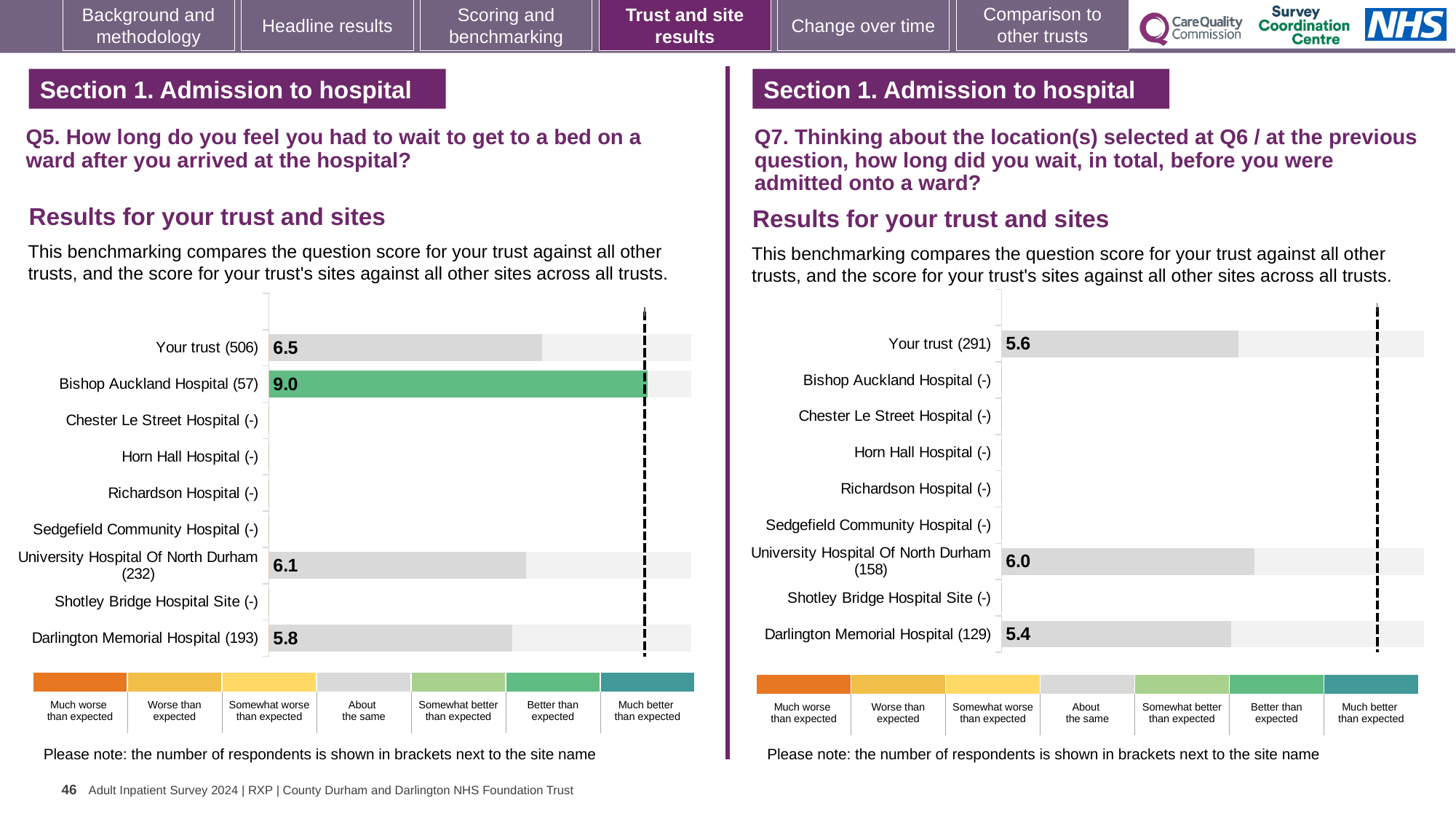
On the Q7 chart (right), what is the score for University Hospital Of North Durham? 6.0 What kind of chart is the Q7 chart (right)? Bar chart On the Q7 chart (right), what is the difference between the University Hospital Of North Durham score and the Darlington Memorial Hospital score? 0.6 On the Q5 chart (left), which site or trust row has the highest score? Bishop Auckland Hospital On the Q5 chart (left), what is the score for Bishop Auckland Hospital? 9.0 How many rows (trust and sites) are listed on the Q5 chart (left)? 9 On the Q5 chart (left), which is larger: the score for University Hospital Of North Durham or the score for Darlington Memorial Hospital? University Hospital Of North Durham On the Q5 chart (left), what is the score for Darlington Memorial Hospital? 5.8 On the Q7 chart (right), what is the score for Your trust? 5.6 On the Q5 chart (left), what is the difference between the Bishop Auckland Hospital score and the Your trust score? 2.5 On the Q5 chart (left), how many respondents are shown in brackets for Your trust? 506 On the Q7 chart (right), which row has the lowest printed score? Darlington Memorial Hospital